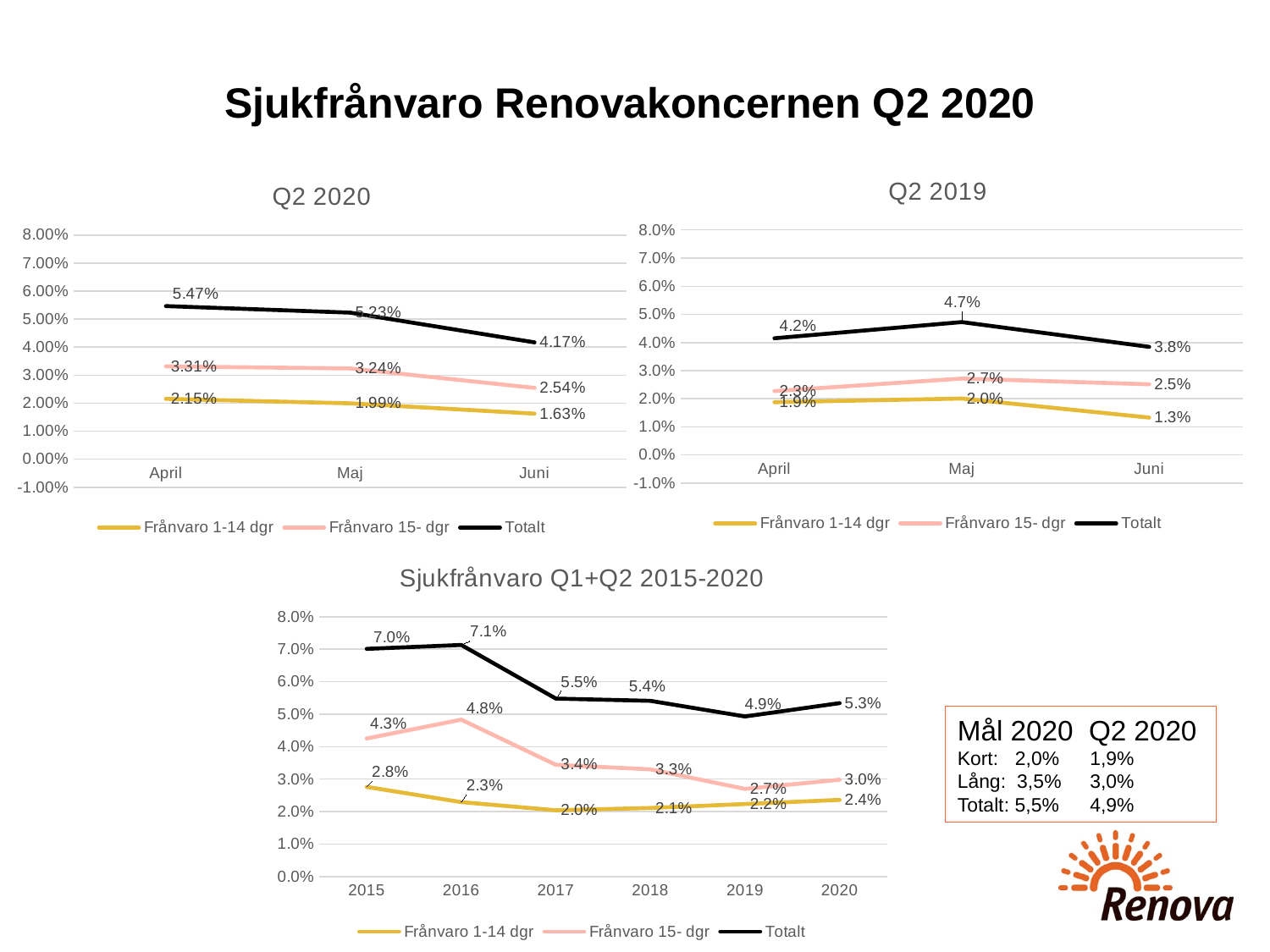
In the Q2 2019 chart, which is larger: Frånvaro 1-14 dgr in April or Frånvaro 1-14 dgr in Juni? April In the Q2 2020 chart, what is the value of Frånvaro 1-14 dgr for Juni? 1.63% In the Q2 2019 chart, in which month is Totalt highest? Maj How many series does the legend of the Sjukfrånvaro Q1+Q2 2015-2020 chart list? 3 In the Sjukfrånvaro Q1+Q2 2015-2020 chart, which year has the highest Totalt value? 2016 In the Sjukfrånvaro Q1+Q2 2015-2020 chart, what is the value of Frånvaro 15- dgr for 2019? 2.7% In the Q2 2020 chart, what is the difference between Totalt in April and Totalt in Juni? 1.30% In the Sjukfrånvaro Q1+Q2 2015-2020 chart, how many years are shown on the x axis? 6 In the Q2 2019 chart, what is the value of Frånvaro 15- dgr for Maj? 2.7% In the Q2 2020 chart, what is the value of Totalt for April? 5.47% In the Q2 2020 chart, does the Totalt series rise or fall from April to Juni? fall What type of chart is the Q2 2020 chart? line chart